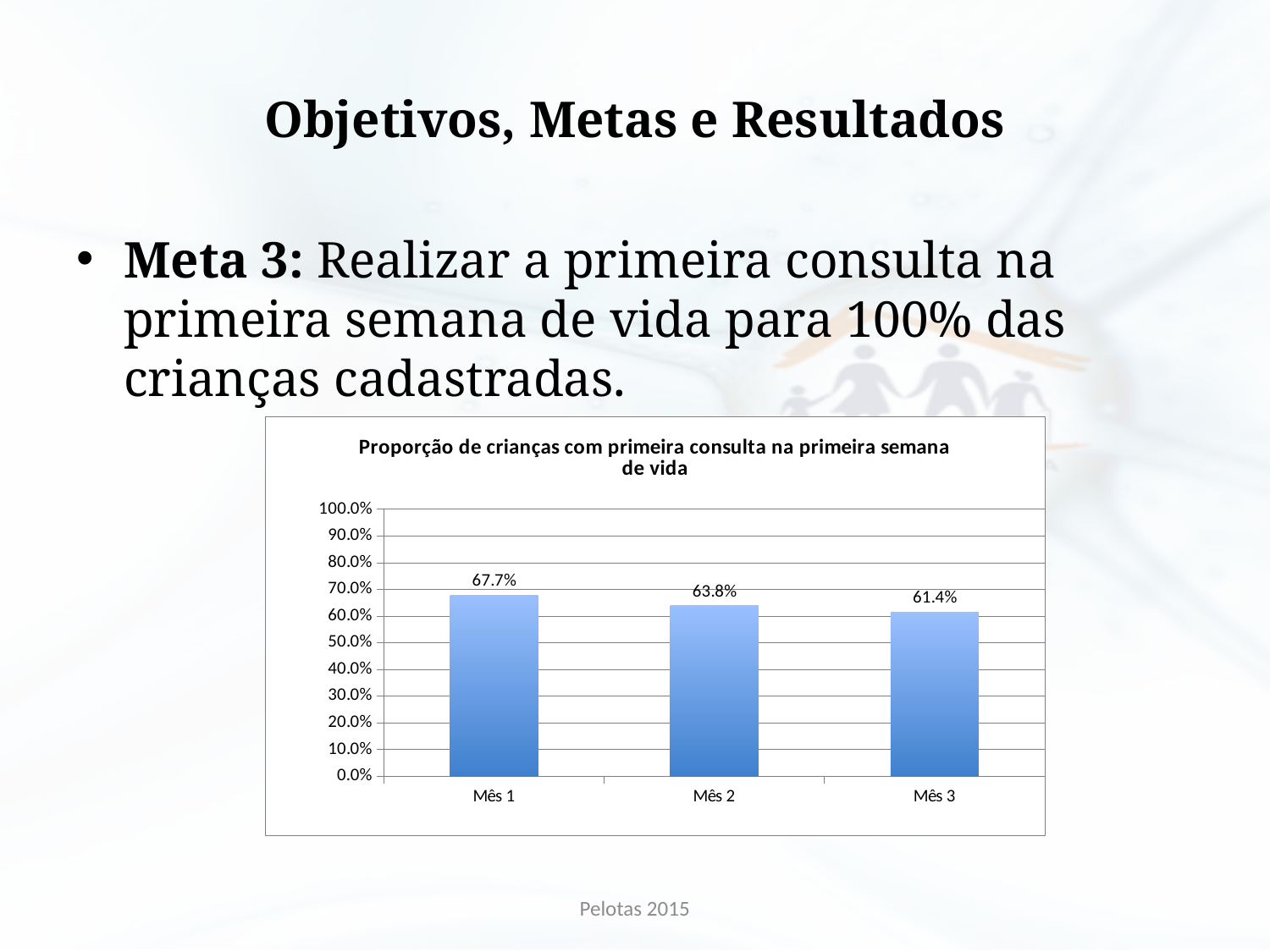
How many months are shown on the chart? 3 Which month has the highest proportion? Mês 1 What is the value for Mês 3? 61.4% Which month has the lowest proportion? Mês 3 What is the value for Mês 2? 63.8% Is the value for Mês 3 greater or less than 70.0%? less What is the difference between the values for Mês 1 and Mês 2? 3.9% What is the value for Mês 1? 67.7% Do the values rise or fall from Mês 1 to Mês 3? fall What kind of chart is shown on the slide? bar chart Which is larger, the value for Mês 2 or the value for Mês 3? Mês 2 What is the difference between the values for Mês 1 and Mês 3? 6.3%